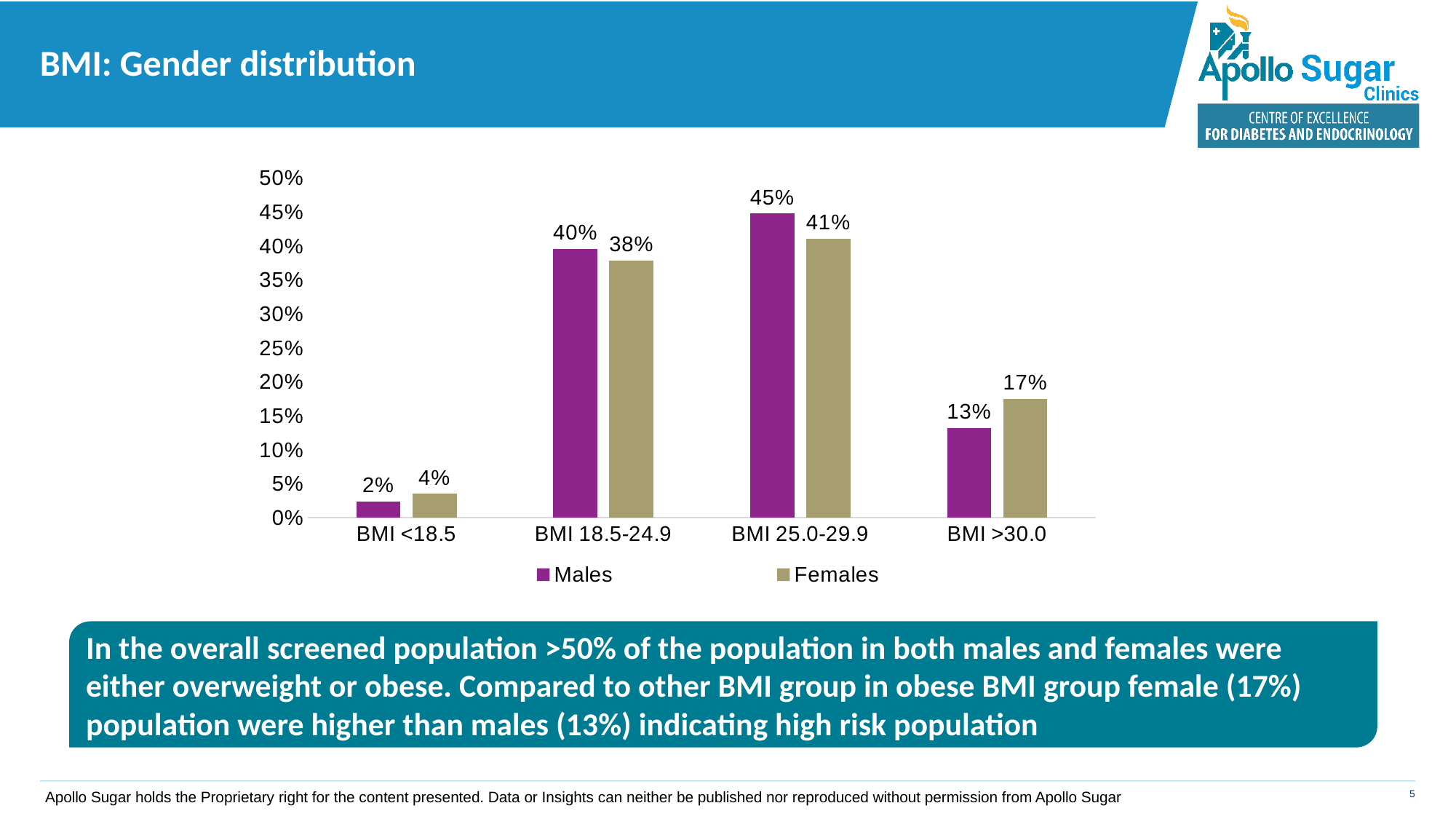
Which BMI category has the lowest value for Females? BMI <18.5 Is the value for Females in the BMI 25.0-29.9 category greater or less than 30%? greater How many series does the legend list? 2 What colour are the Males bars? Purple In the BMI 18.5-24.9 category, which is larger, the Males value or the Females value? Males How many BMI categories are shown on the x axis? 4 What is the difference between the Males and Females values in the BMI >30.0 category? 4% What is the value for Males in the BMI 25.0-29.9 category? 45% What is the value for Females in the BMI <18.5 category? 4% Which BMI category has the highest value for Males? BMI 25.0-29.9 What is the value for Females in the BMI >30.0 category? 17% What kind of chart is shown on the slide? Bar chart